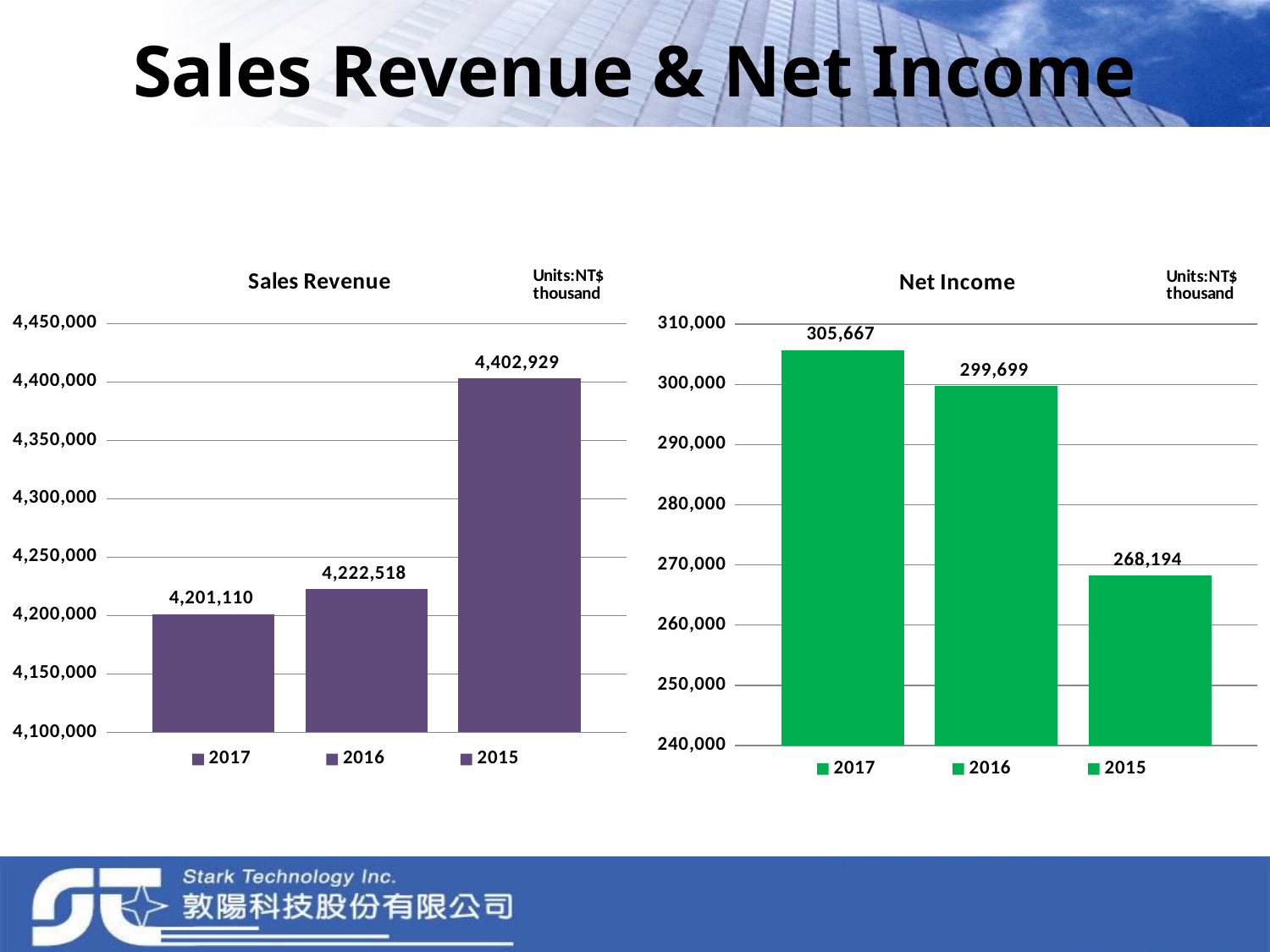
In the Sales Revenue chart, what is the difference between the 2015 value and the 2017 value? 201,819 In the Net Income chart, what is the value for 2015? 268,194 In the Net Income chart, which year has the lowest value? 2015 What kind of chart is the Sales Revenue chart? Bar chart In the Net Income chart, what is the difference between the 2017 value and the 2016 value? 5,968 In the Net Income chart, what is the value for 2016? 299,699 In the Sales Revenue chart, which year has the highest value? 2015 How many bars are shown in the Net Income chart? 3 In the Net Income chart, which is larger, the value for 2017 or the value for 2015? 2017 In the Sales Revenue chart, what is the value for 2015? 4,402,929 In the Sales Revenue chart, what is the value for 2017? 4,201,110 What unit is stated for the values in the Net Income chart? NT$ thousand